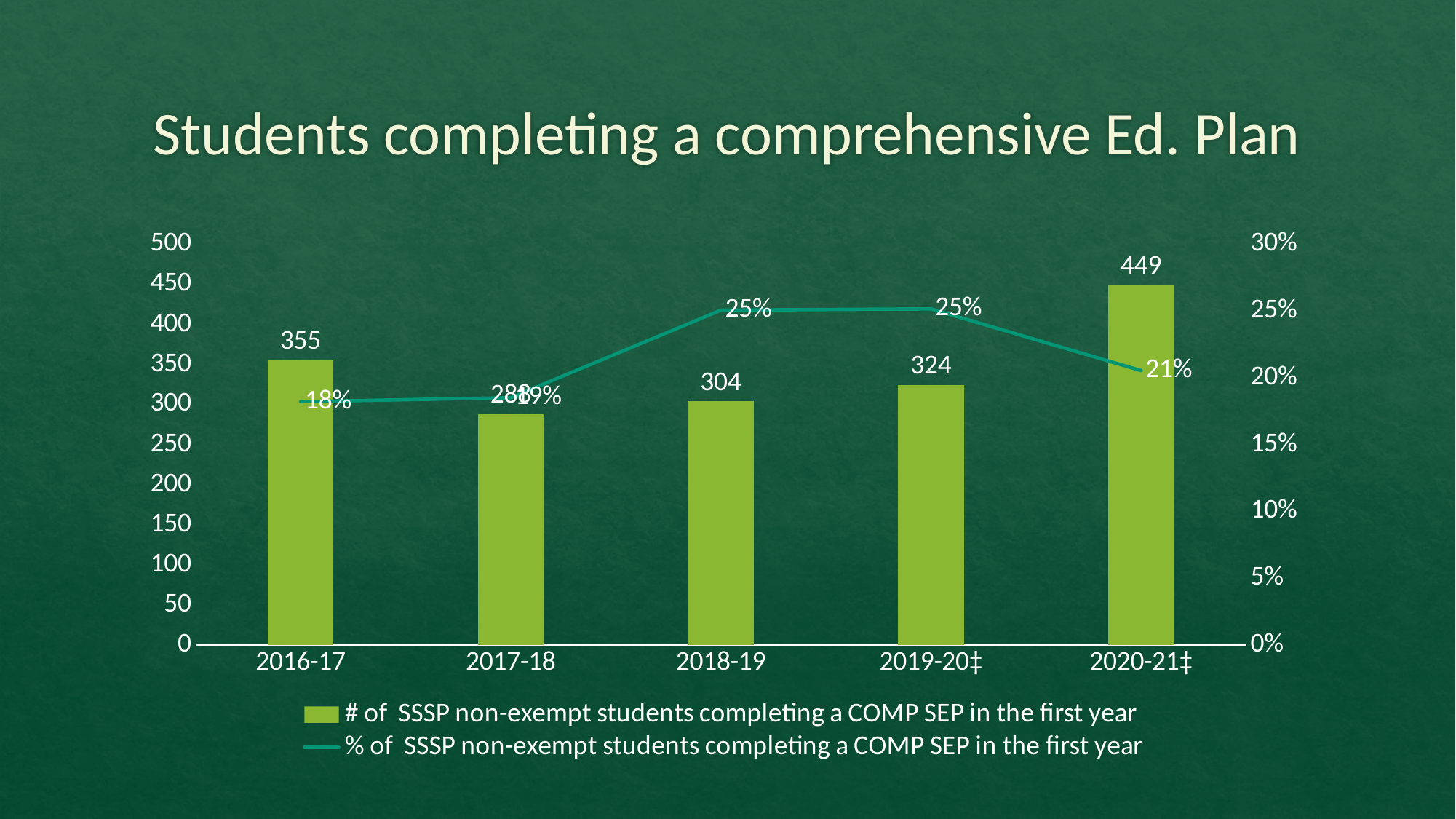
What is the number of SSSP non-exempt students completing a COMP SEP in the first year for 2016-17? 355 How many series does the legend list? 2 What percentage of SSSP non-exempt students completed a COMP SEP in the first year in 2020-21‡? 21% Which year has the highest number of SSSP non-exempt students completing a COMP SEP in the first year? 2020-21‡ What is the number of SSSP non-exempt students completing a COMP SEP in the first year for 2018-19? 304 Is the number of students completing a COMP SEP in 2017-18 greater or less than 300? less How many years are shown on the x axis of the chart? 5 What is the number of SSSP non-exempt students completing a COMP SEP in the first year for 2020-21‡? 449 What is the difference in the number of students completing a COMP SEP between 2020-21‡ and 2016-17? 94 What percentage of SSSP non-exempt students completed a COMP SEP in the first year in 2018-19? 25% Which year has the larger number of students completing a COMP SEP, 2018-19 or 2019-20‡? 2019-20‡ Does the percentage of students completing a COMP SEP rise or fall from 2016-17 to 2018-19? rise